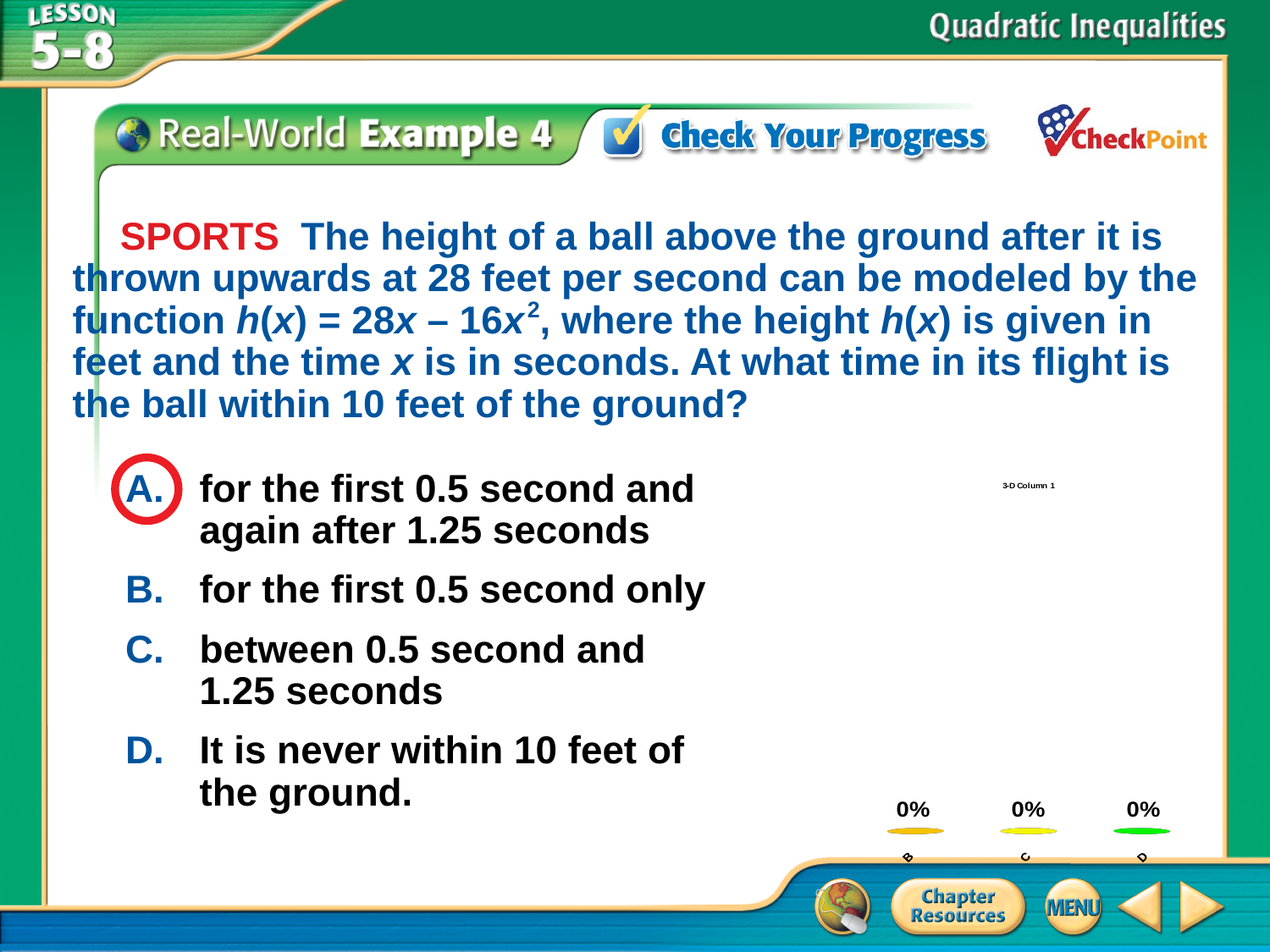
What value is shown for category B in the chart? 0% What is the difference between the values for B and C in the chart? 0% What value is shown for category C in the chart? 0% What value is shown for category D in the chart? 0% What is the total of the values shown for B, C and D in the chart? 0% What colour is the bar for category D in the chart? green Are the values for B and D in the chart equal? Yes What is the title printed above the chart? 3-D Column 1 What kind of chart is shown on the slide? bar chart Do the values rise, fall, or stay the same from B to D in the chart? stay the same